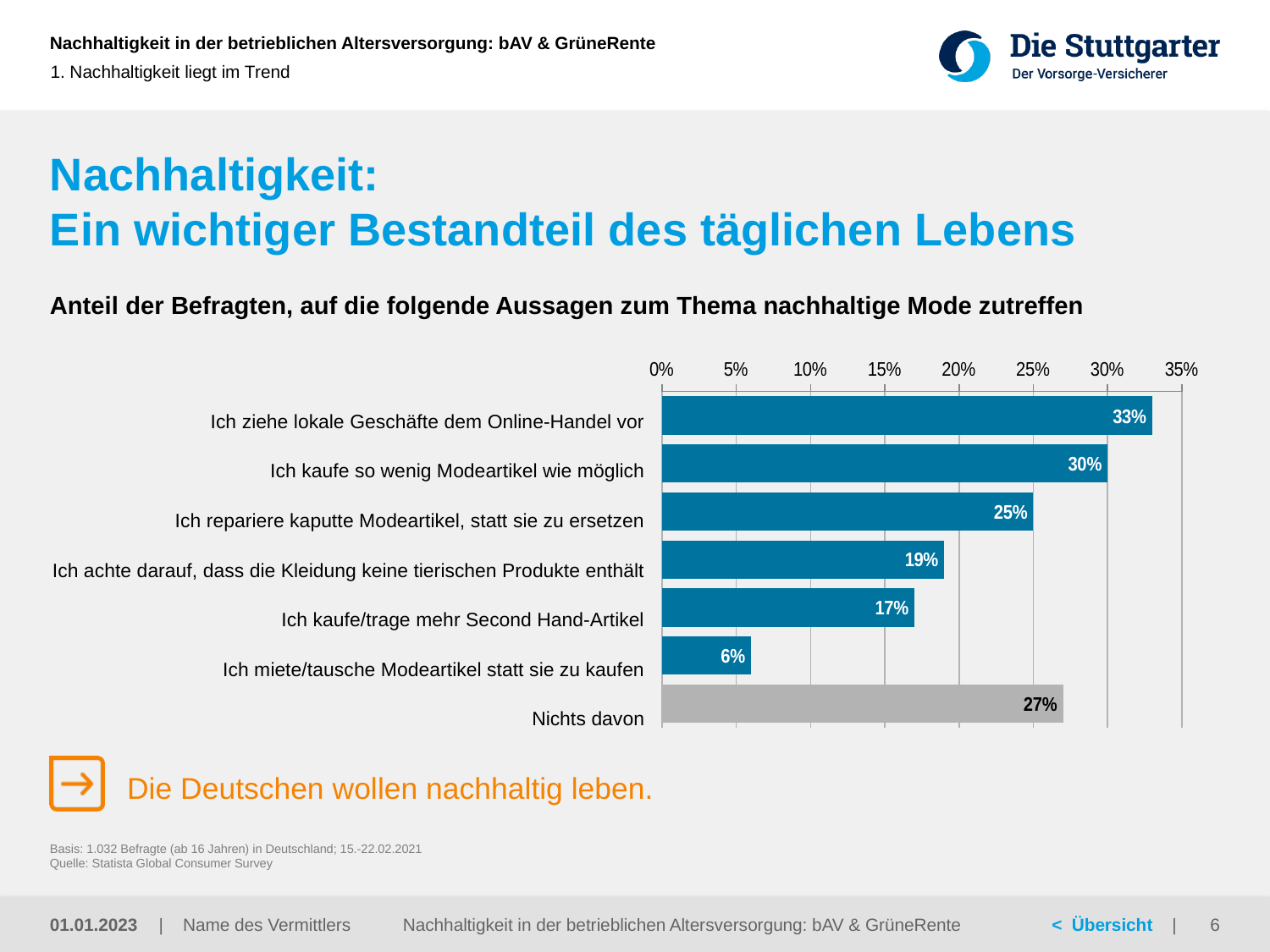
What is the value for "Ich kaufe/trage mehr Second Hand-Artikel"? 17% What is the value for "Nichts davon"? 27% What percentage of respondents say "Ich ziehe lokale Geschäfte dem Online-Handel vor"? 33% Which statement has the lowest share of respondents? Ich miete/tausche Modeartikel statt sie zu kaufen Which bar is shown in grey instead of blue? Nichts davon Which is larger: the value for "Ich achte darauf, dass die Kleidung keine tierischen Produkte enthält" or for "Nichts davon"? Nichts davon What kind of chart is shown on the slide? Bar chart Is the value for "Ich repariere kaputte Modeartikel, statt sie zu ersetzen" greater or less than 20%? greater What is the difference between the highest value and the value for "Ich miete/tausche Modeartikel statt sie zu kaufen"? 27% What is the difference between "Ich kaufe so wenig Modeartikel wie möglich" and "Ich repariere kaputte Modeartikel, statt sie zu ersetzen"? 5% Which statement has the highest share of respondents? Ich ziehe lokale Geschäfte dem Online-Handel vor How many statements (bars) are shown in the chart? 7